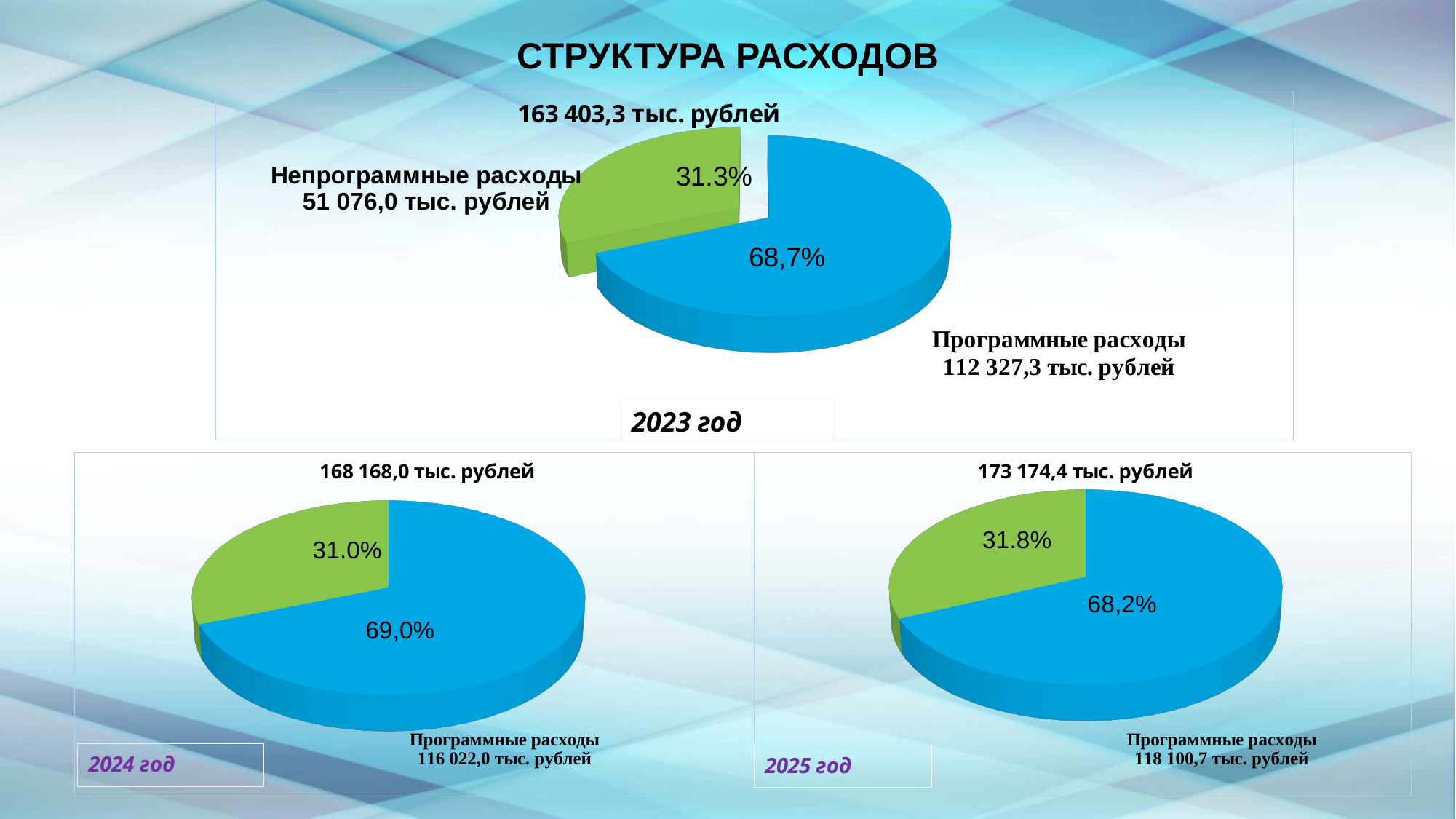
How many pie charts are on the slide? 3 In the 2025 год chart, which slice is larger, the blue one (Программные расходы) or the green one? The blue one (Программные расходы) What total amount is shown above the 2025 год chart? 173 174,4 тыс. рублей In the 2024 год chart, what percentage is shown for the blue slice (Программные расходы)? 69,0% In the 2025 год chart, what percentage is shown for the green slice? 31.8% In the 2023 год chart, what is the value given for Непрограммные расходы? 51 076,0 тыс. рублей What total amount is shown above the 2023 год chart? 163 403,3 тыс. рублей In the 2023 год chart, what is the value given for Программные расходы? 112 327,3 тыс. рублей In the 2024 год chart, what is the value given for Программные расходы? 116 022,0 тыс. рублей In the 2023 год chart, what percentage share is shown for Программные расходы? 68,7% What type of charts are shown on the slide? Pie charts In the 2023 год chart, what percentage share is shown for Непрограммные расходы? 31.3%